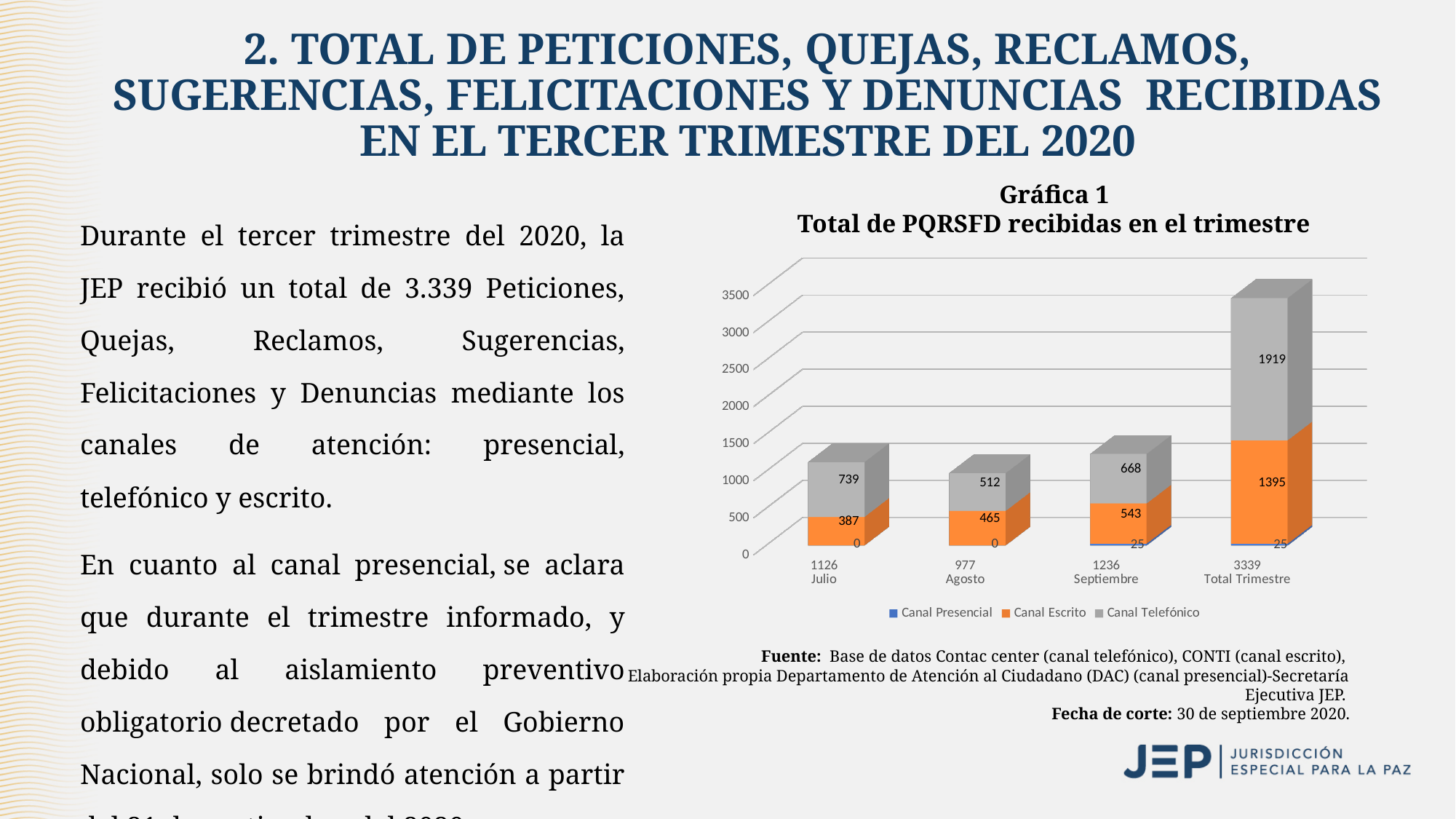
How many series does the legend list? 3 What kind of chart is shown? Stacked bar chart Which month (Julio, Agosto or Septiembre) has the lowest Canal Telefónico value? Agosto Which month (Julio, Agosto or Septiembre) has the highest Canal Escrito value? Septiembre What is the difference between the Canal Telefónico values for Julio and Septiembre? 71 What is the value of Canal Escrito for Agosto? 465 What is the total of the stacked bar for Agosto? 977 What is the value of Canal Telefónico for Julio? 739 How many categories are shown on the x axis? 4 Is the Canal Escrito value larger for Julio or for Agosto? Agosto What is the value of Canal Telefónico for Total Trimestre? 1919 What is the value of Canal Presencial for Septiembre? 25